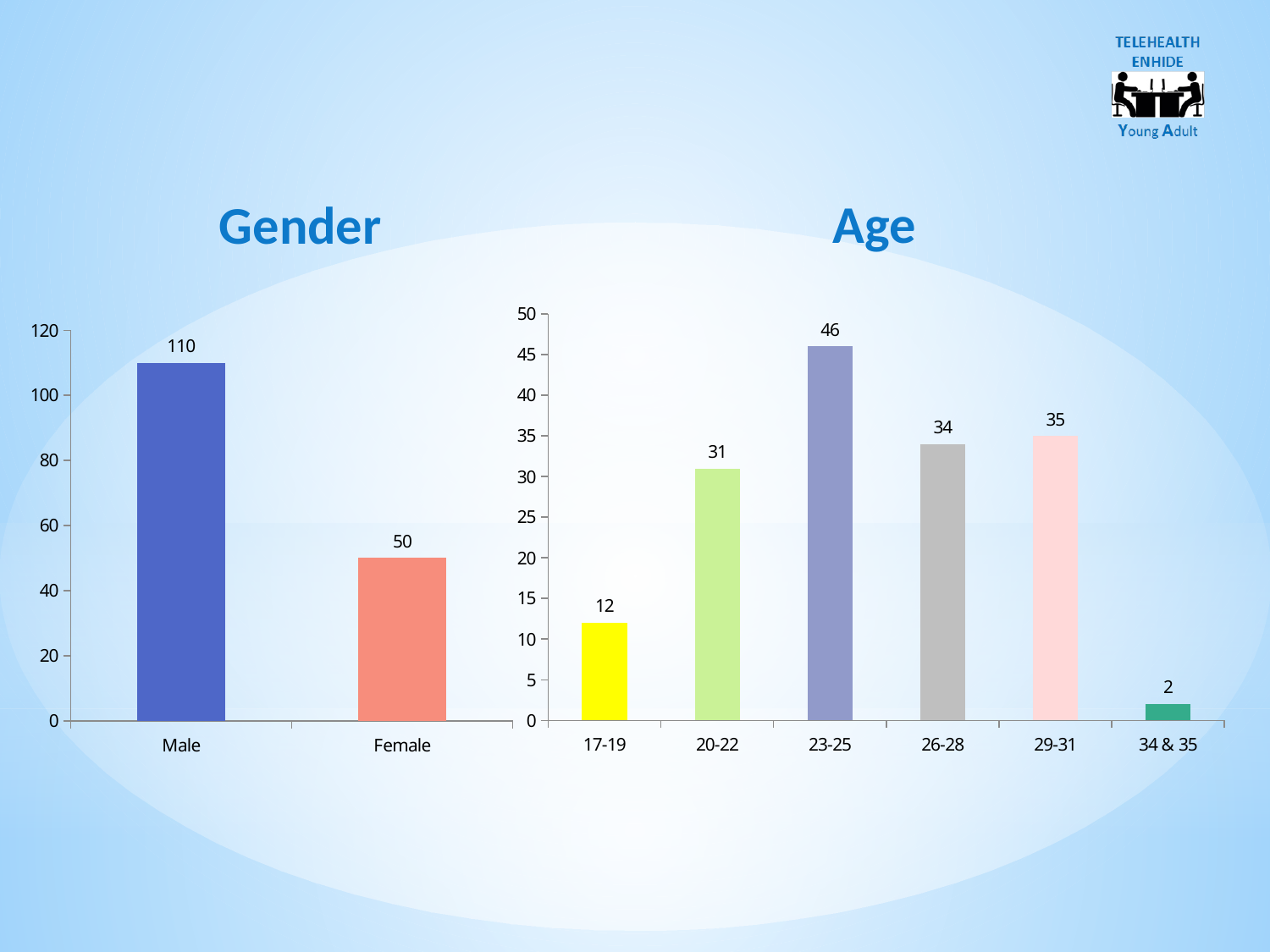
In the Age chart, what is the value for the 34 & 35 age group? 2 In the Age chart, what is the difference between the values for 29-31 and 26-28? 1 In the Age chart, how many age groups are shown? 6 In the Age chart, which age group has the highest value? 23-25 In the Gender chart, which category has the higher value, Male or Female? Male In the Gender chart, what is the value for Female? 50 In the Gender chart, what is the value for Male? 110 In the Age chart, which age group has the lowest value? 34 & 35 In the Age chart, what is the value for the 23-25 age group? 46 What kind of chart is the Age chart? Bar chart In the Age chart, which is larger, the value for 20-22 or the value for 17-19? 20-22 In the Gender chart, what is the difference between the Male and Female values? 60